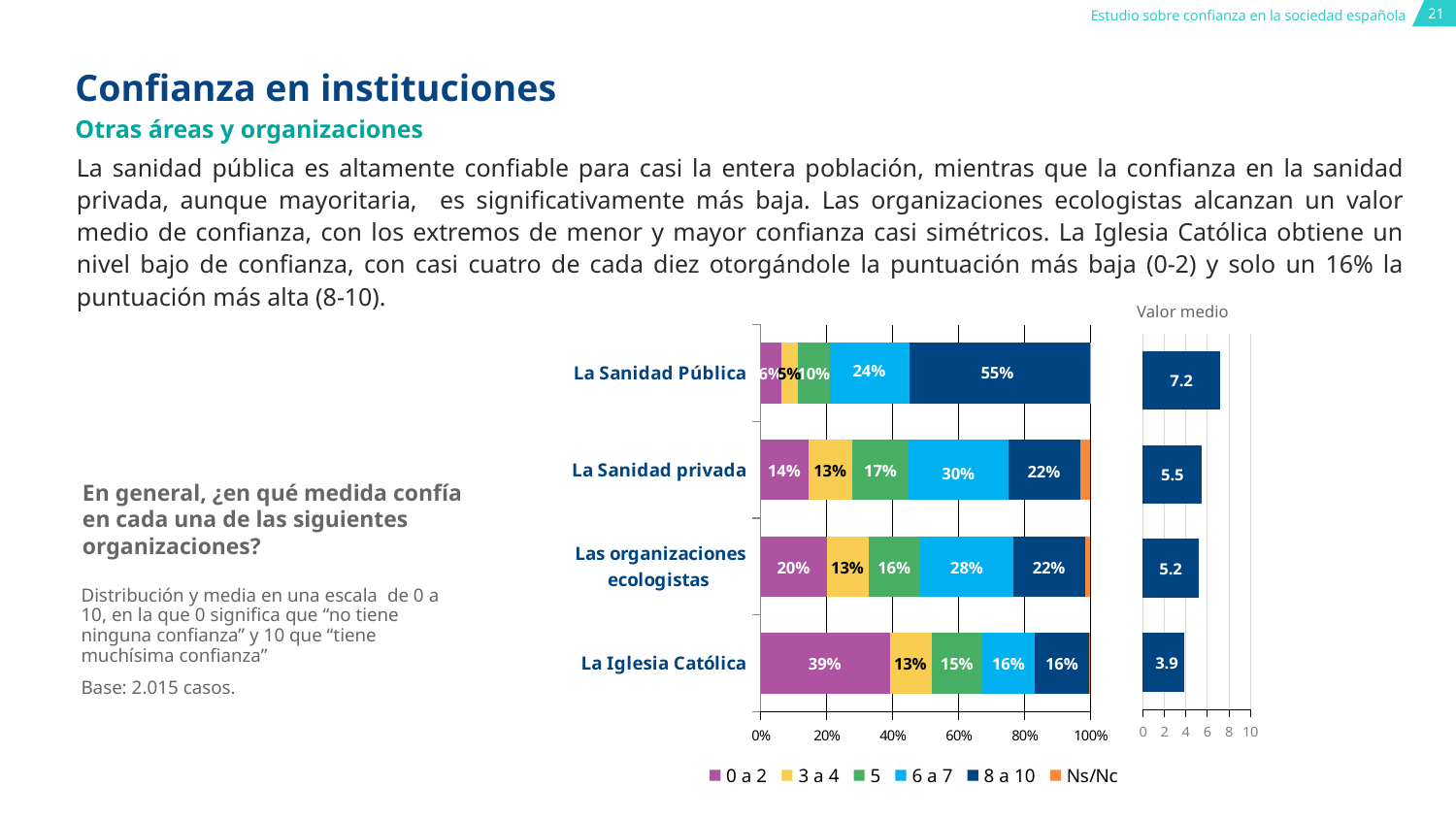
What type of chart is the Valor medio chart? Bar chart How many series does the legend of the stacked bar chart list? 6 In the stacked bar chart, what is the difference between the 0 a 2 shares of La Iglesia Católica and Las organizaciones ecologistas? 19% In the Valor medio chart, what is the difference between the mean values of La Sanidad Pública and La Iglesia Católica? 3.3 In the Valor medio chart, what is the mean value for Las organizaciones ecologistas? 5.2 In the stacked bar chart, what is the 6 a 7 value for La Sanidad privada? 30% In the stacked bar chart, what percentage of respondents gave La Sanidad Pública a score of 8 a 10? 55% How many organizations are shown in the stacked bar chart? 4 In the stacked bar chart, which has a larger 8 a 10 share: La Sanidad privada or La Iglesia Católica? La Sanidad privada In the Valor medio chart, which organization has the highest mean value? La Sanidad Pública In the stacked bar chart, what percentage gave La Iglesia Católica a score of 0 a 2? 39% In the Valor medio chart, which organization has the lowest mean value? La Iglesia Católica